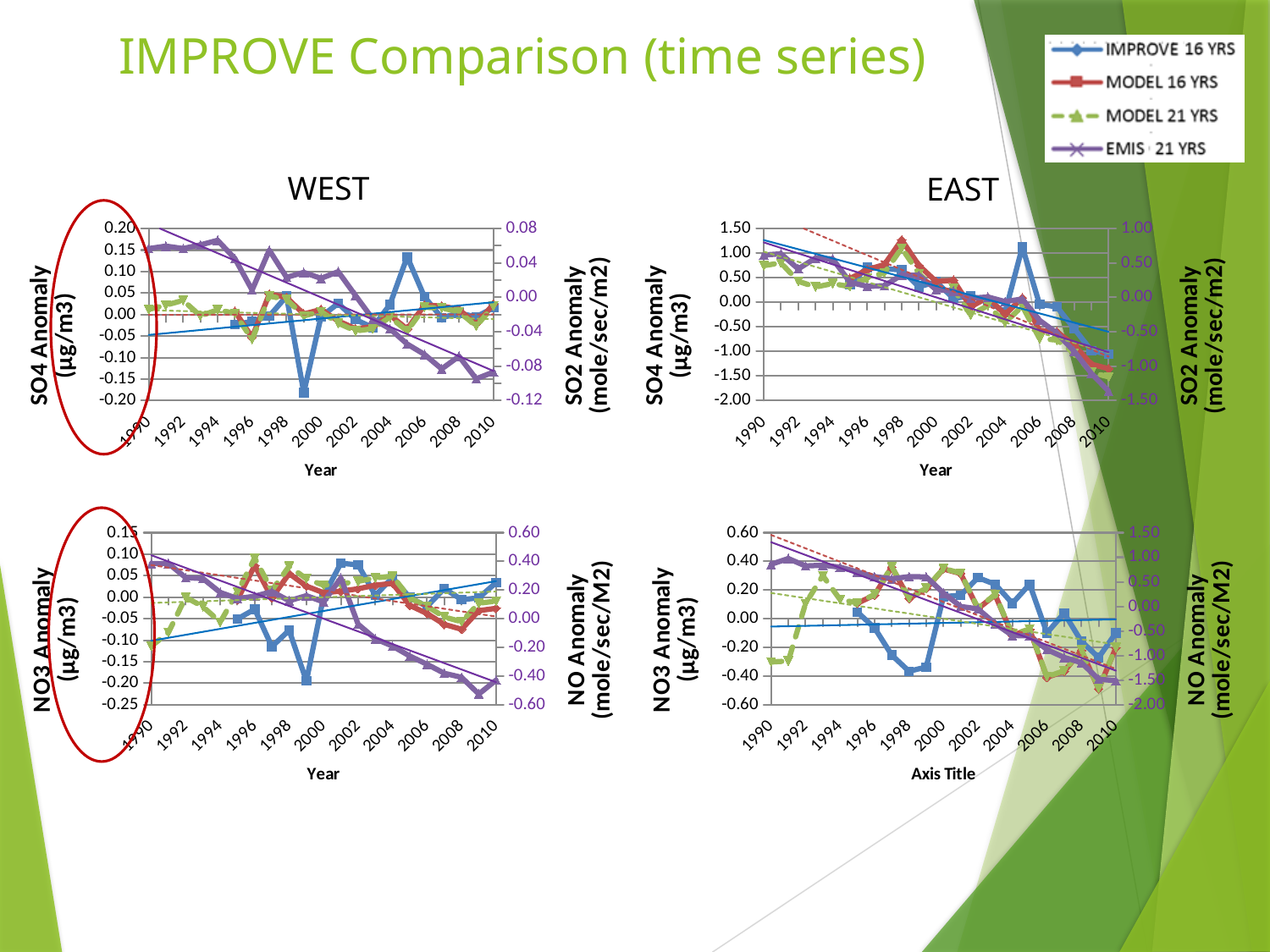
In the WEST SO4 Anomaly chart (top left), is the IMPROVE 16 YRS peak around 2005 greater or less than 0.05? greater In the WEST SO4 Anomaly chart (top left), is the IMPROVE 16 YRS value at its lowest point around 1999 greater or less than -0.10? less What is the label of the right-hand vertical axis on the WEST SO4 Anomaly chart (top left)? SO2 Anomaly (mole/sec/m2) In the EAST SO4 Anomaly chart (top right), does the EMIS 21 YRS series generally rise or fall from 1990 to 2010? fall In the EAST NO3 Anomaly chart (bottom right), is the IMPROVE 16 YRS value at its lowest point around 1998 greater or less than -0.20? less How many series does the legend at the top right of the slide list? 4 How many charts are shown on the slide? 4 What is the x-axis title of the EAST NO3 Anomaly chart (bottom right)? Axis Title What kind of chart is the WEST SO4 Anomaly chart? line chart In the WEST NO3 Anomaly chart (bottom left), does the EMIS 21 YRS series generally rise or fall from 1990 to 2010? fall